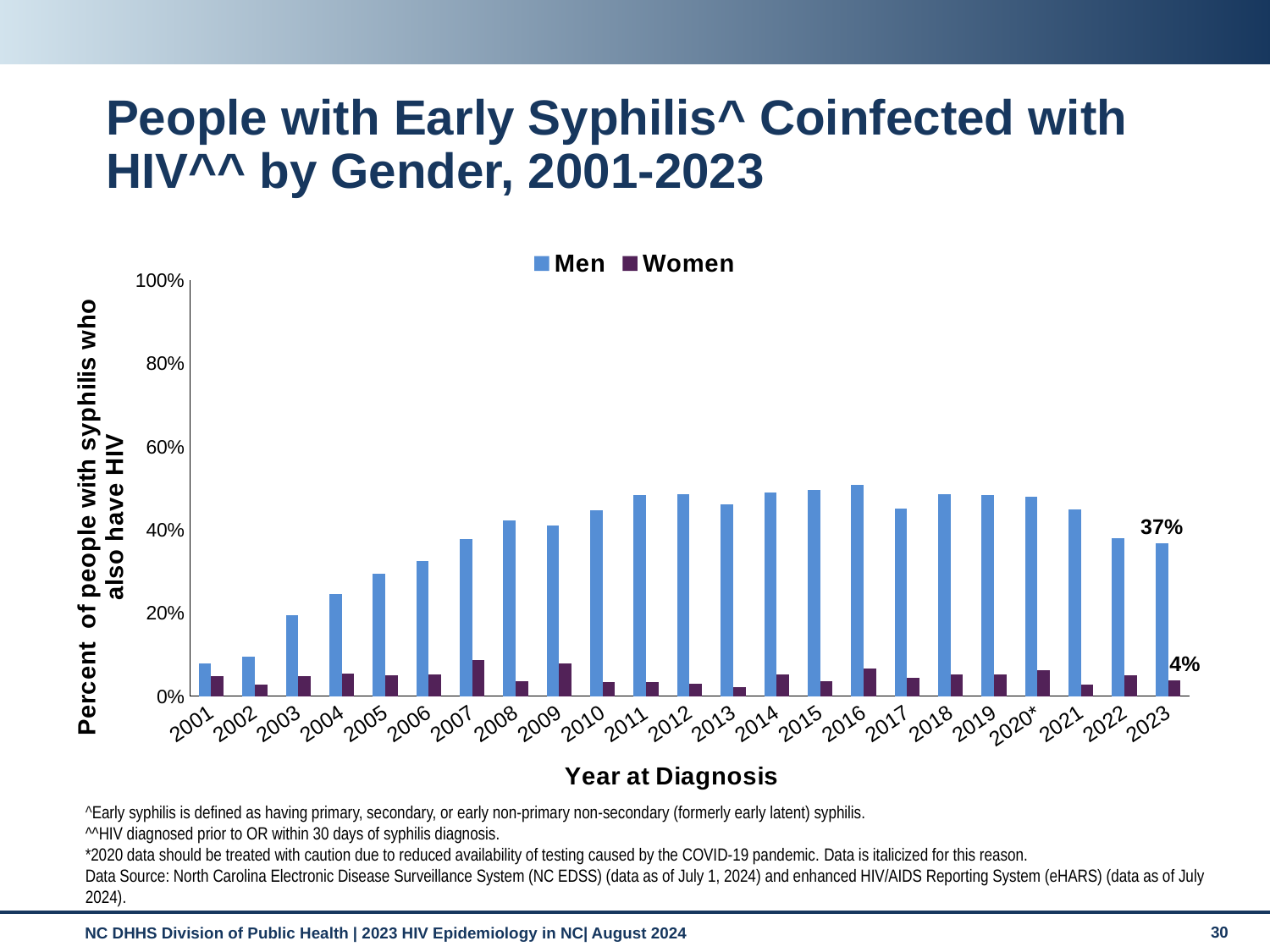
Do the values for Men rise or fall from 2001 to 2011? Rise What is the value for Women in 2023? 4% What is the difference between the Men and Women values in 2023? 33 percentage points What kind of chart is shown on the slide? Bar chart In 2023, which series has the larger value, Men or Women? Men Which year has the lowest value for Men? 2001 Is the value for Men in 2001 greater or less than 20%? less How many years are shown on the x axis? 23 Is the value for Men in 2016 greater or less than 40%? greater How many series does the legend list? 2 What is the value for Men in 2023? 37% Is the value for Women in 2007 greater or less than 20%? less